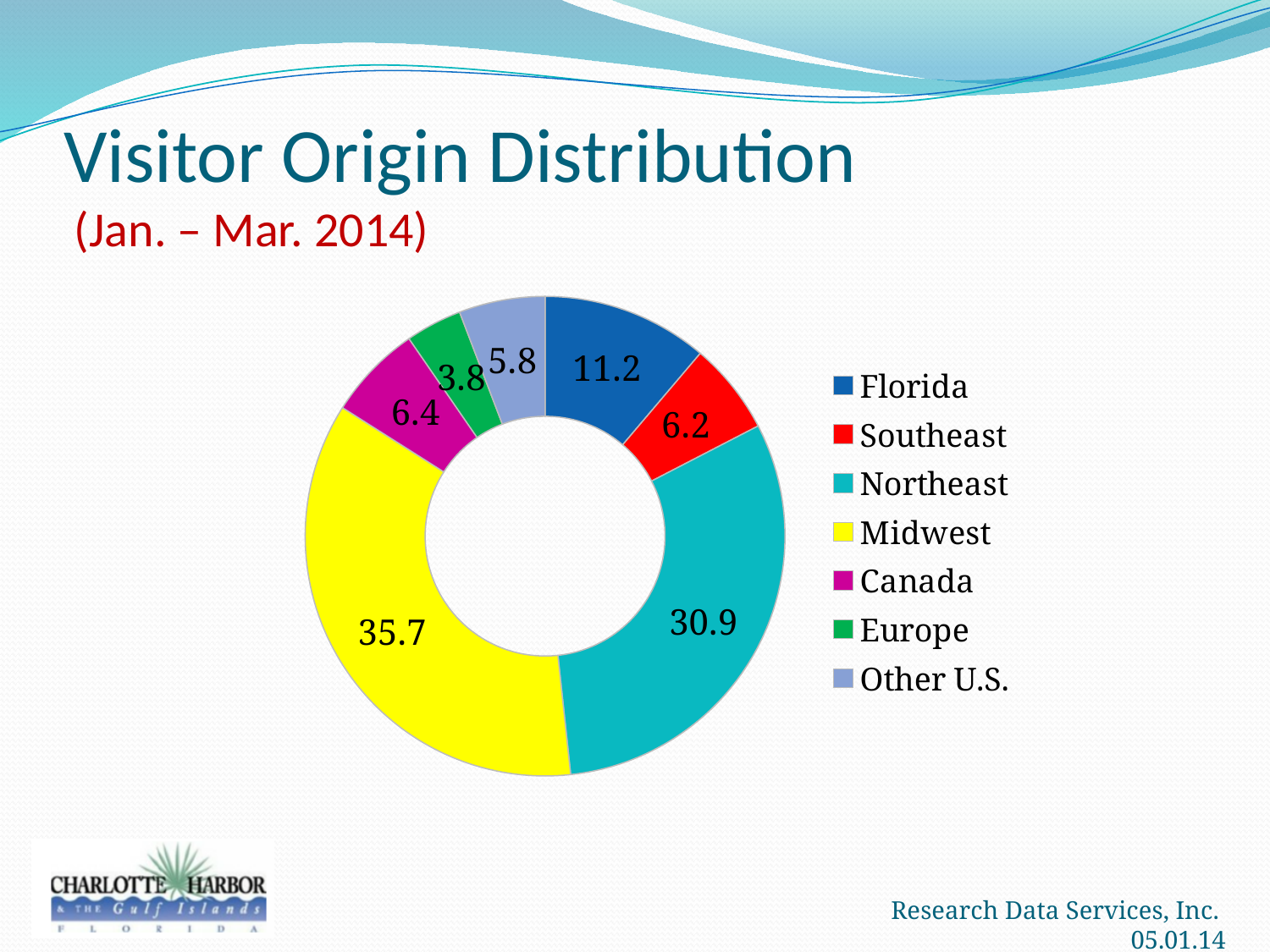
Which is larger, the value for Florida or the value for Other U.S.? Florida What is the value shown for Canada? 6.4 Which visitor origin has the smallest share? Europe What colour represents Midwest in the chart? Yellow What is the value shown for Europe? 3.8 What is the value shown for Northeast? 30.9 What kind of chart is shown on the slide? Doughnut chart What is the value shown for Florida? 11.2 How many visitor origin categories are shown in the chart? 7 What is the combined value of Florida and Southeast? 17.4 Which visitor origin has the largest share? Midwest What is the difference between the Midwest and Northeast values? 4.8